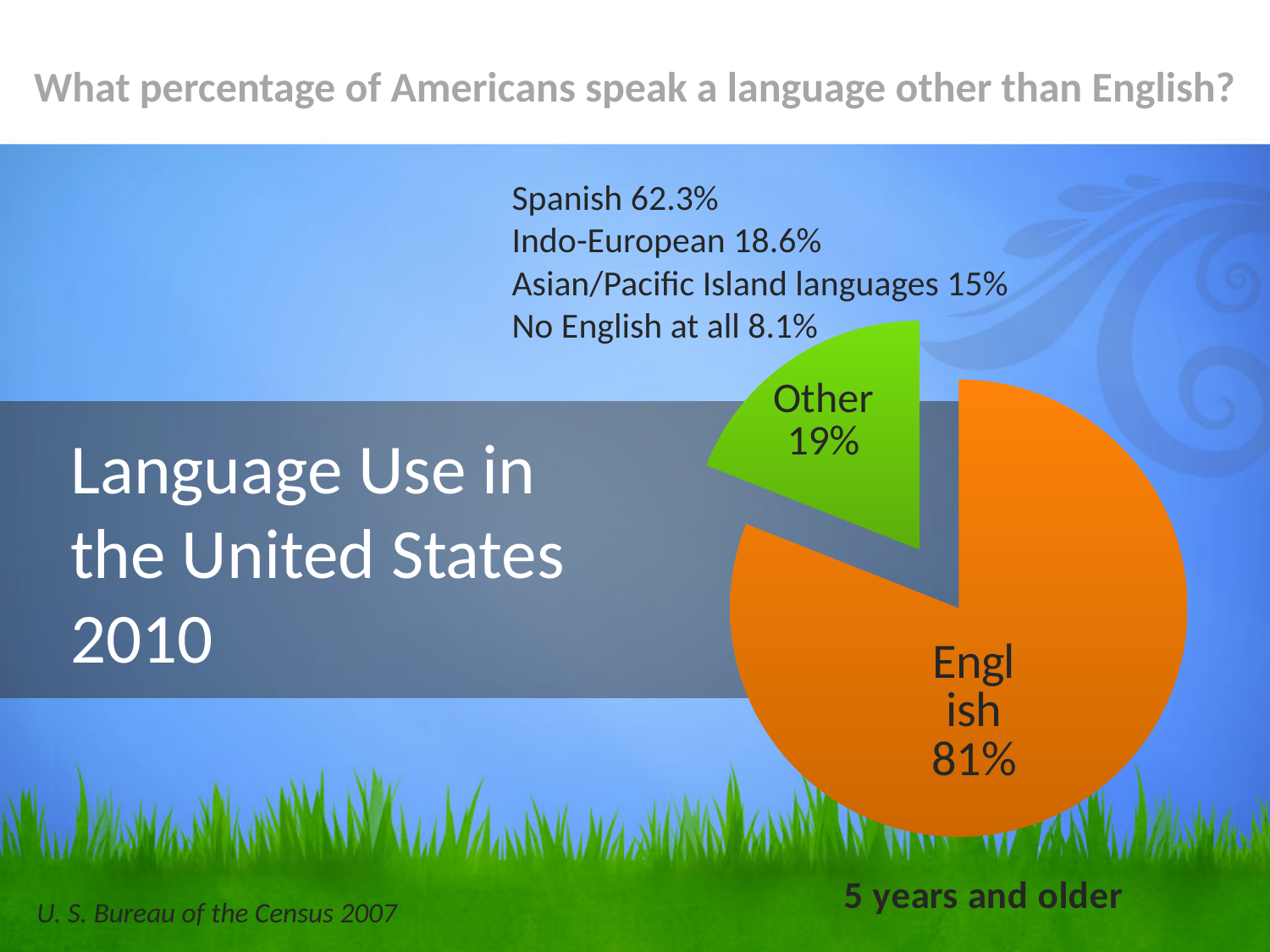
What percentage does the Other slice of the pie chart represent? 19% What colour is the Other slice of the pie chart? green What percentage does the English slice of the pie chart represent? 81% What colour is the English slice of the pie chart? orange Which slice of the pie chart is the smallest? Other Which slice of the pie chart is the largest? English How many slices does the pie chart have? 2 What is the difference in percentage points between the English and Other slices? 62 Which is larger, the English slice or the Other slice? English Is the value for the Other slice greater or less than 50%? less What kind of chart is shown on the slide? pie chart